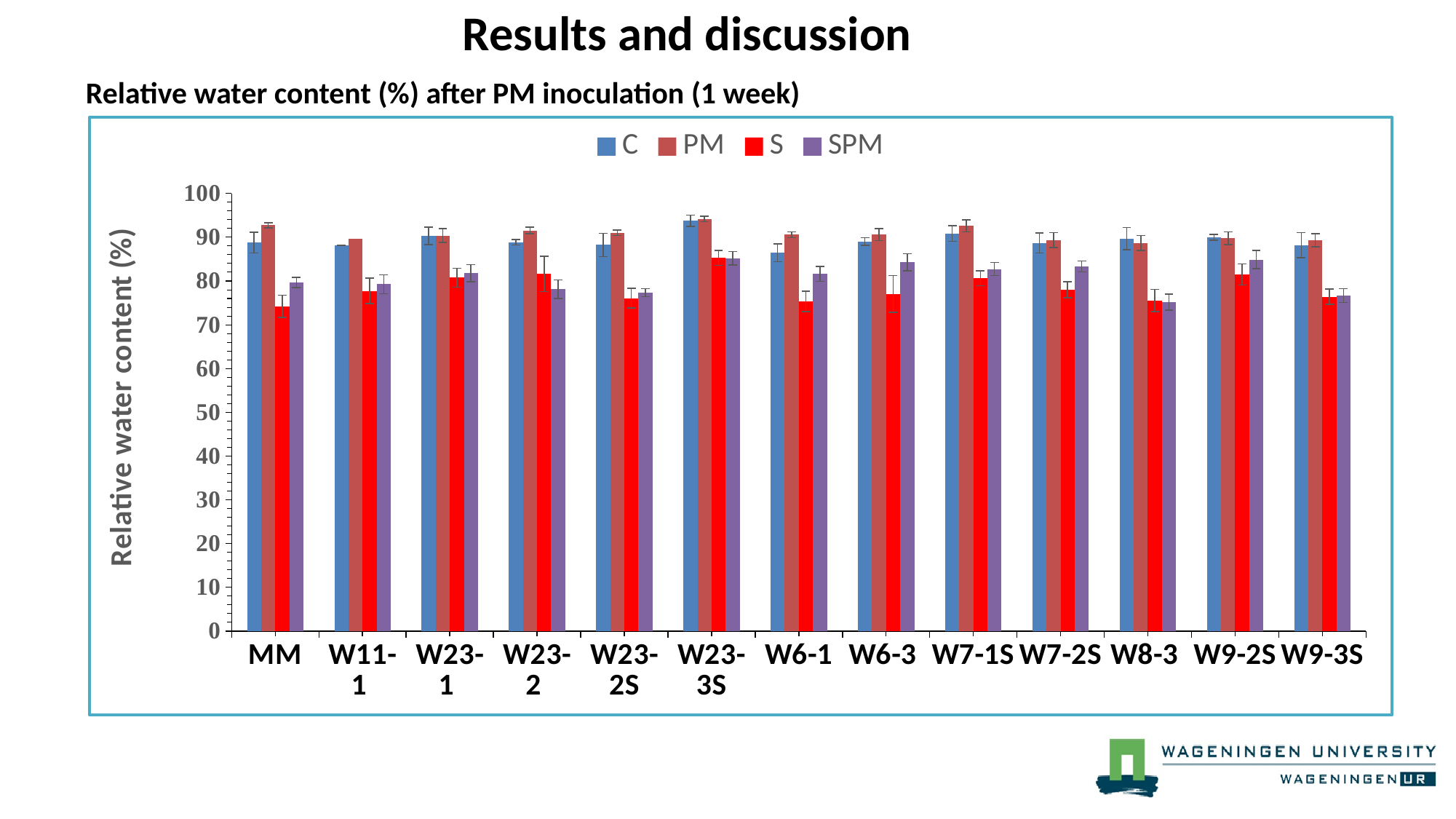
Is the value of the SPM series for W9-3S greater or less than 80? less How many series does the legend list? 4 For MM, which is larger, the PM value or the S value? PM How many categories are shown along the x axis? 13 Is the value of the S series for MM greater or less than 80? less Is the value of the PM series for MM greater or less than 90? greater What is the title of the y axis? Relative water content (%) What kind of chart is shown on the slide? bar chart For W23-3S, which is larger, the C value or the S value? C Which category has the highest value in the S series? W23-3S